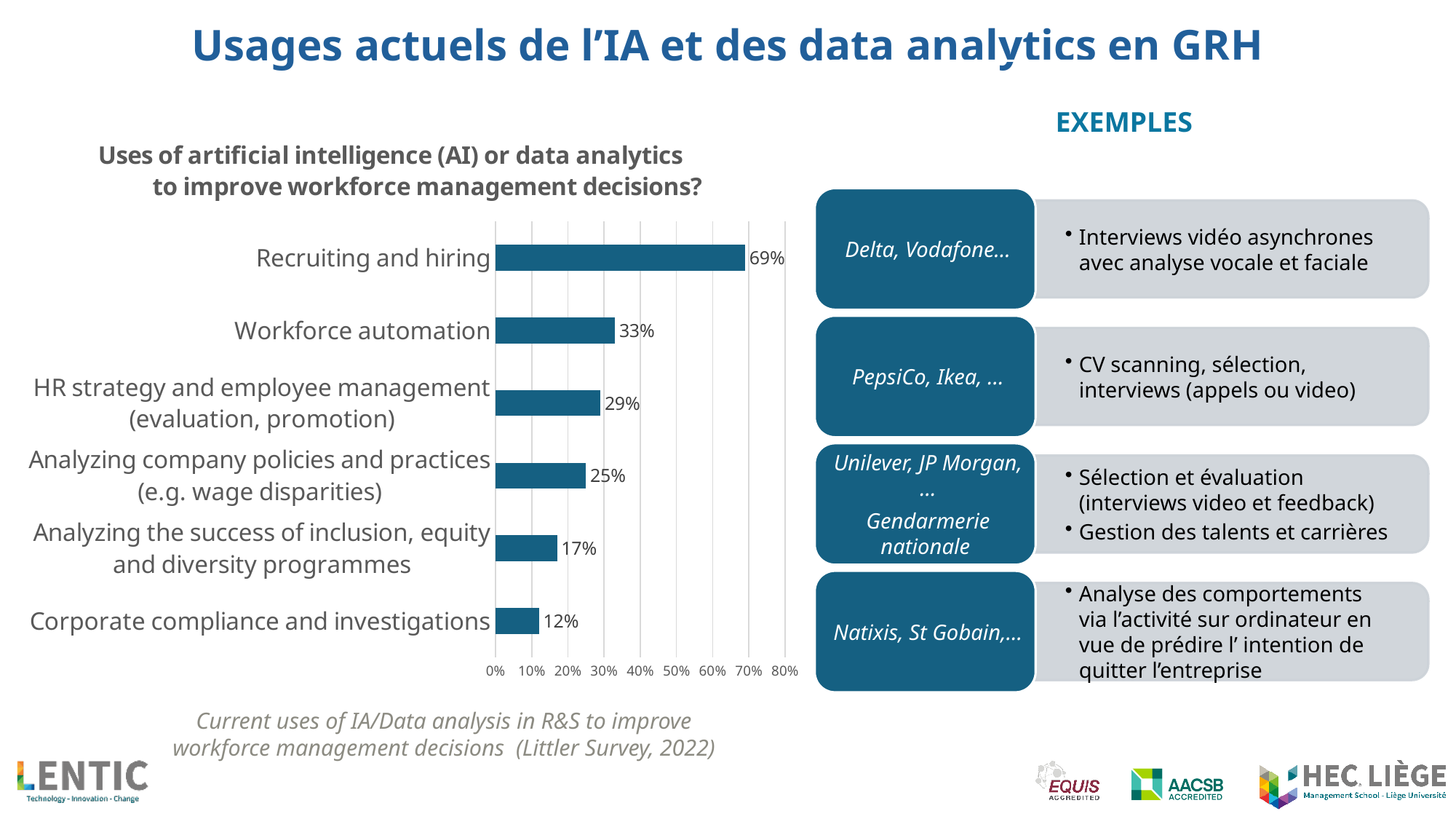
What is the difference between the values for Recruiting and hiring and Workforce automation? 36% Is the value for Recruiting and hiring greater or less than 60%? greater What percentage is shown for Recruiting and hiring? 69% What percentage is shown for Workforce automation? 33% What percentage is shown for Corporate compliance and investigations? 12% Which category has the lowest value? Corporate compliance and investigations What kind of chart is shown on the slide? Bar chart How many categories are shown in the chart? 6 Which category has the highest value? Recruiting and hiring What percentage is shown for Analyzing the success of inclusion, equity and diversity programmes? 17% Which is larger: HR strategy and employee management (evaluation, promotion) or Analyzing company policies and practices (e.g. wage disparities)? HR strategy and employee management (evaluation, promotion) What is the title of the chart? Uses of artificial intelligence (AI) or data analytics to improve workforce management decisions?